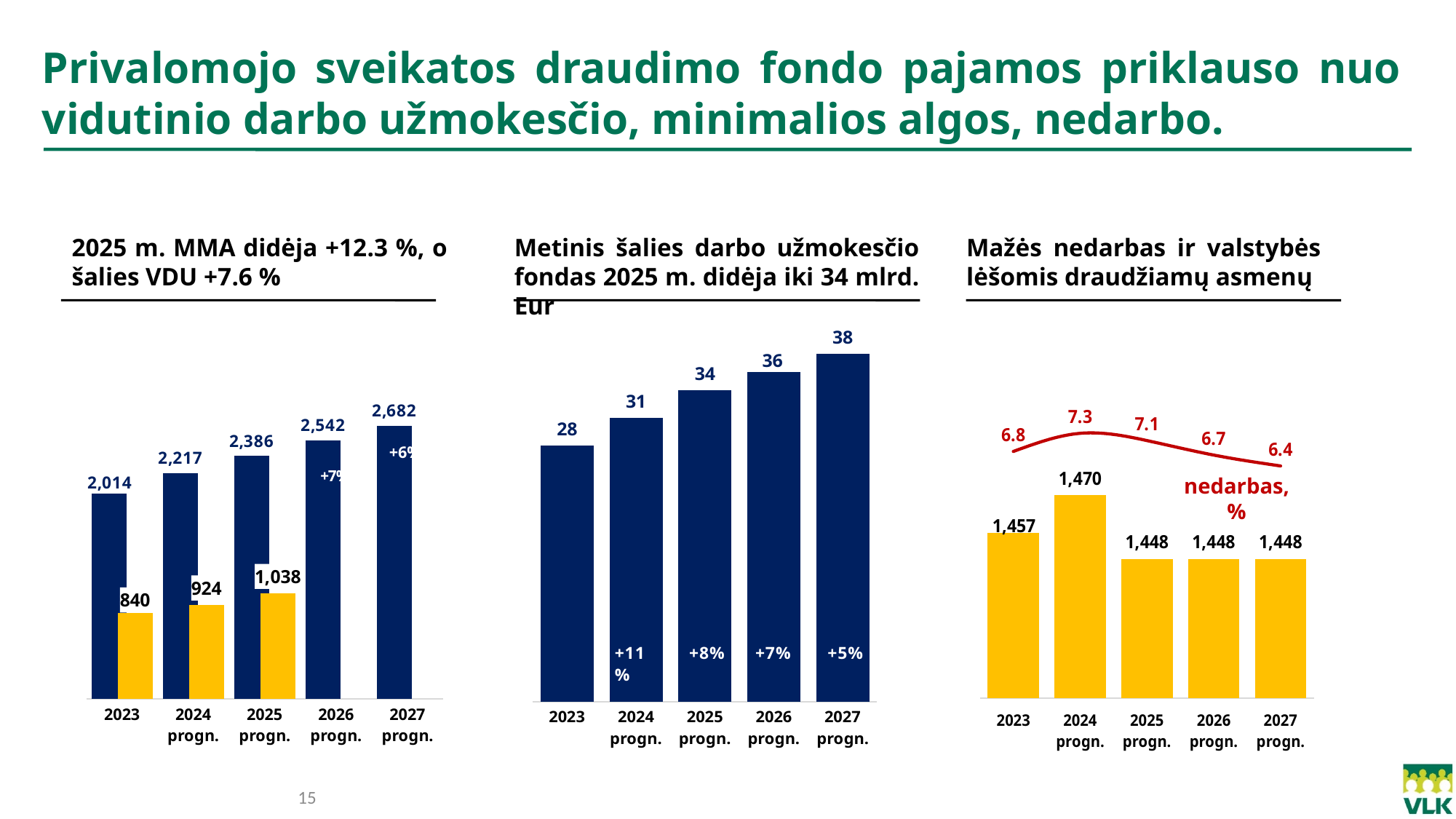
In the left chart (2025 m. MMA didėja +12.3 %, o šalies VDU +7.6 %), what is the value of the yellow bar for 2025 progn.? 1,038 In the middle chart (Metinis šalies darbo užmokesčio fondas), what is the value for 2025 progn.? 34 In the right chart (Mažės nedarbas ir valstybės lėšomis draudžiamų asmenų), what is the value of the yellow bar for 2024 progn.? 1,470 In the middle chart (Metinis šalies darbo užmokesčio fondas), which year has the highest value? 2027 progn. In the left chart (2025 m. MMA didėja +12.3 %, o šalies VDU +7.6 %), what is the difference between the dark blue bar values for 2027 progn. and 2026 progn.? 140 In the middle chart (Metinis šalies darbo užmokesčio fondas), do the values rise or fall from 2023 to 2027 progn.? rise In the middle chart (Metinis šalies darbo užmokesčio fondas), what is the difference between the values for 2027 progn. and 2023? 10 In the left chart (2025 m. MMA didėja +12.3 %, o šalies VDU +7.6 %), what is the value of the dark blue bar for 2023? 2,014 In the left chart (2025 m. MMA didėja +12.3 %, o šalies VDU +7.6 %), how many years are shown on the x axis? 5 In the right chart (Mažės nedarbas ir valstybės lėšomis draudžiamų asmenų), what is the nedarbas, % value for 2027 progn.? 6.4 In the middle chart (Metinis šalies darbo užmokesčio fondas), what kind of chart is it? bar chart In the right chart (Mažės nedarbas ir valstybės lėšomis draudžiamų asmenų), which year has the highest nedarbas, % value on the red line? 2024 progn.